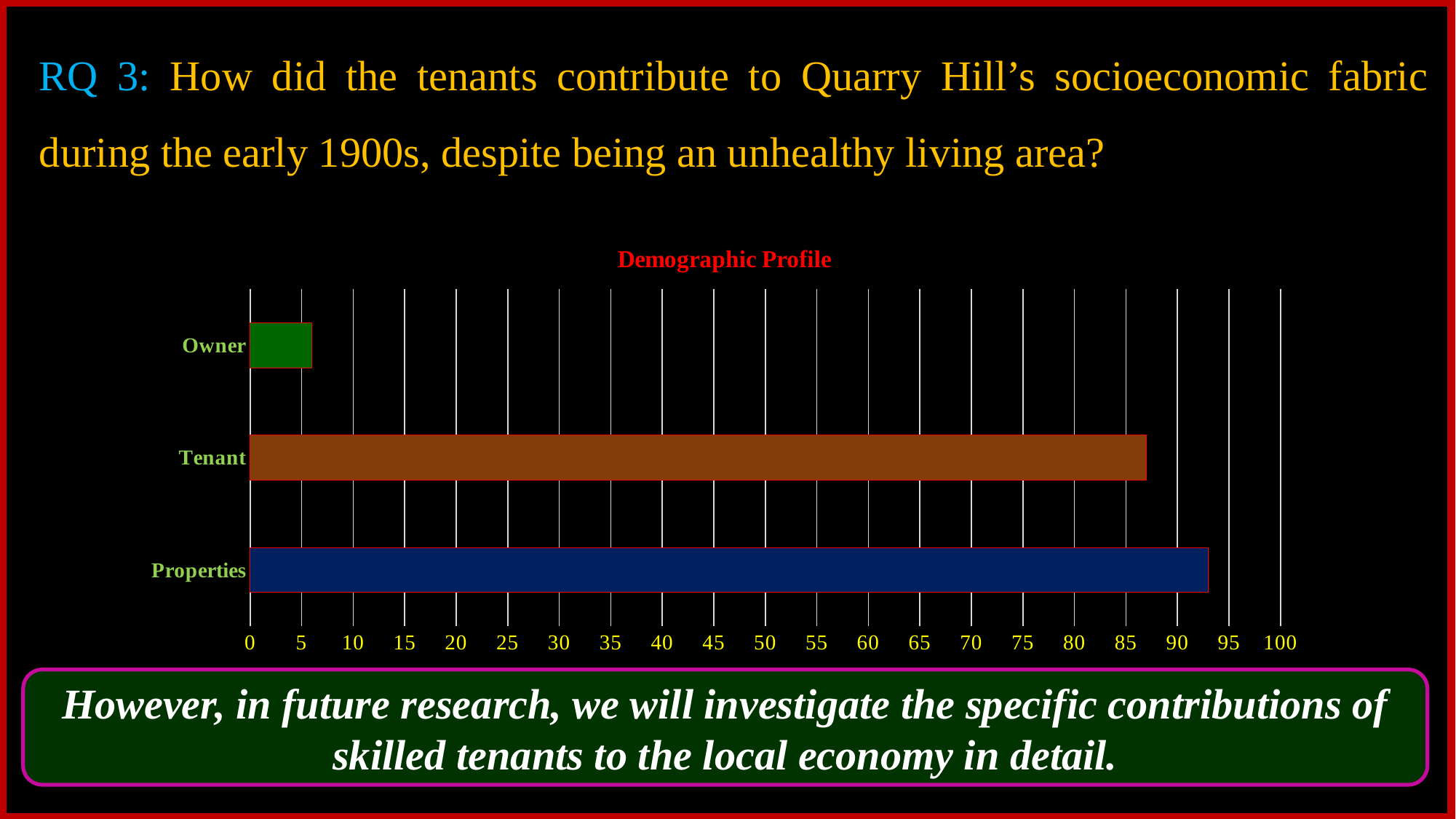
Is the value for Tenant greater or less than 80? greater Which category has the highest value in the chart? Properties What kind of chart is shown on the slide? bar chart What colour is the bar for Tenant? brown Which is larger, the value for Tenant or the value for Owner? Tenant Is the value for Properties greater or less than 90? greater How many categories are plotted in the chart? 3 Is the value for Owner greater or less than 10? less Which category has the lowest value in the chart? Owner Which is larger, the value for Properties or the value for Tenant? Properties What is the title of the chart? Demographic Profile